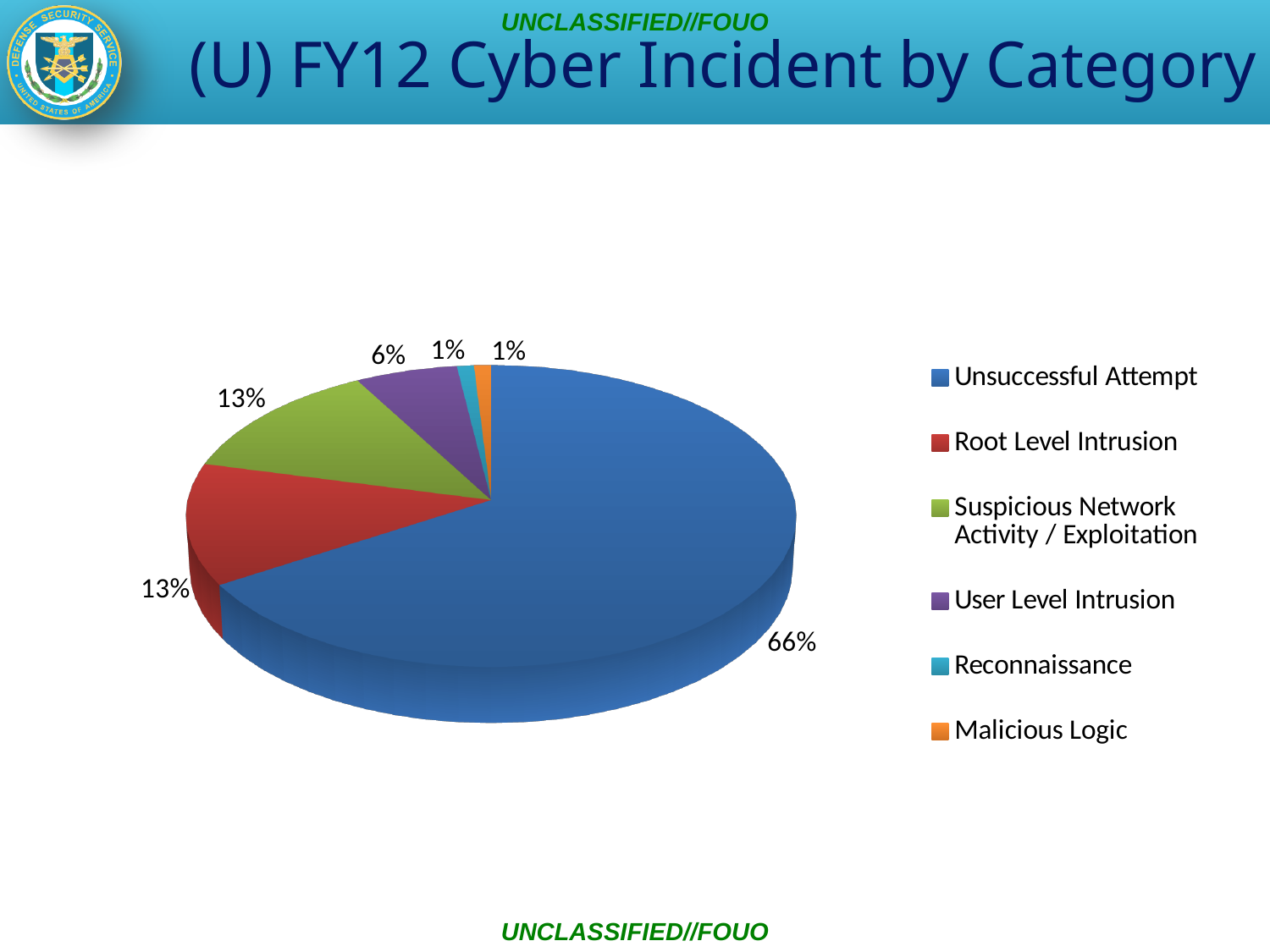
What is the title of the chart slide? (U) FY12 Cyber Incident by Category What percentage of incidents were Reconnaissance? 1% Which is larger, the share for User Level Intrusion or the share for Malicious Logic? User Level Intrusion What kind of chart is shown on the slide? Pie chart Which category accounts for the largest share of FY12 cyber incidents? Unsuccessful Attempt Which category is shown in orange in the legend? Malicious Logic What share of FY12 cyber incidents were Unsuccessful Attempts? 66% What is the difference in percentage points between Unsuccessful Attempt and Root Level Intrusion? 53 What percentage of incidents were Root Level Intrusions? 13% How many categories does the pie chart show? 6 What percentage of incidents were Suspicious Network Activity / Exploitation? 13% What percentage of incidents were User Level Intrusions? 6%